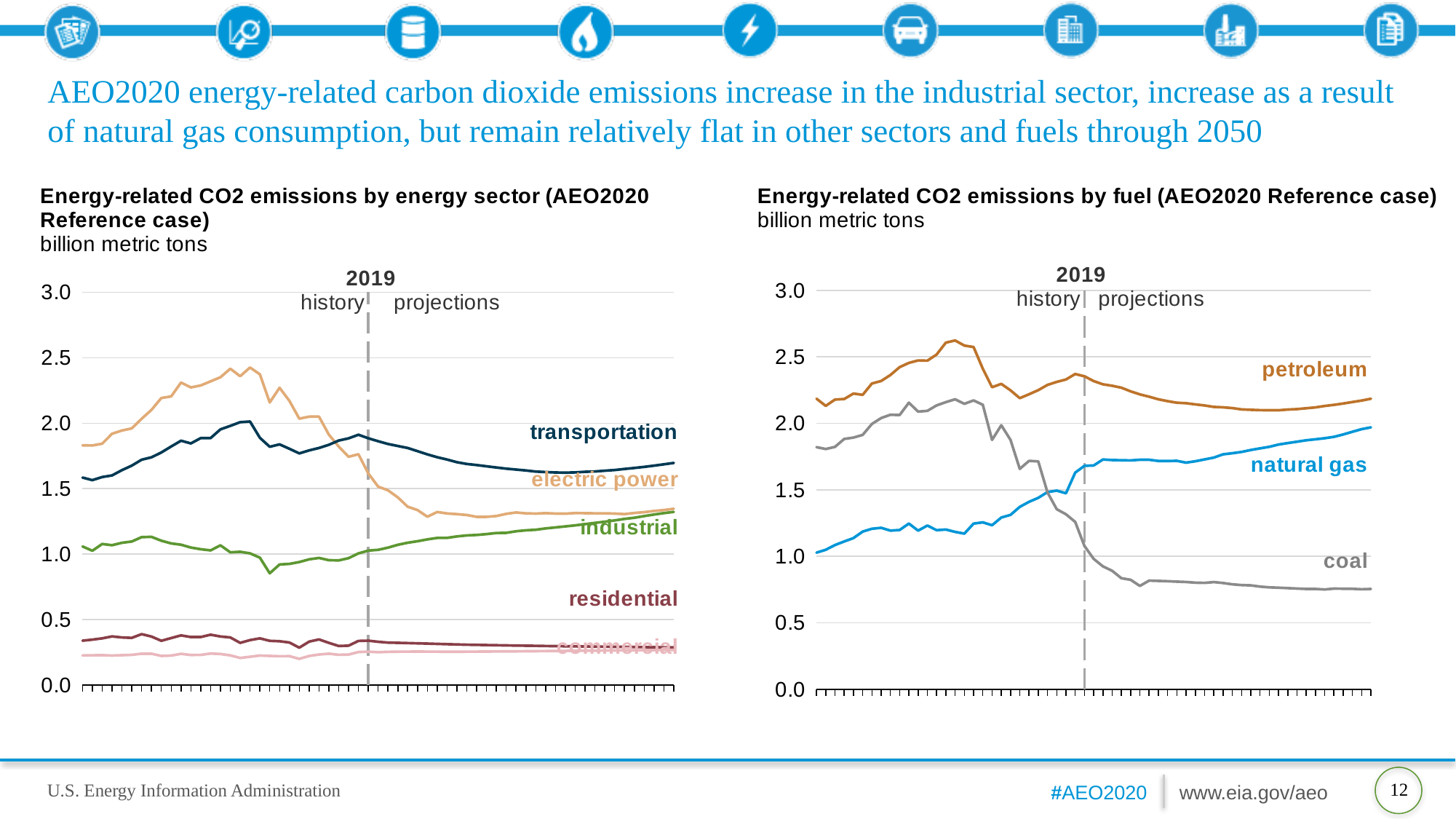
What type of chart is the 'Energy-related CO2 emissions by energy sector' chart on the left? line chart On the left chart (by energy sector), which sector has the highest emissions at the end of the projection period? transportation What unit is used on the y axis of both charts? billion metric tons On the right chart (by fuel), which fuel has the lowest emissions at the end of the projection period? coal On the right chart (by fuel), is the value for coal at the end of the projection period greater or less than 1.0? less How many series are labelled on the right chart, 'Energy-related CO2 emissions by fuel'? 3 On the left chart (by energy sector), is the value for transportation at the end of the projection period greater or less than 1.5? greater On the right chart (by fuel), is the value for petroleum at the end of the projection period greater or less than 2.0? greater On the left chart (by energy sector), which sector has the lowest emissions at the end of the projection period? commercial On the right chart (by fuel), which is larger at the end of the projection period, petroleum or natural gas? petroleum How many series are labelled on the left chart, 'Energy-related CO2 emissions by energy sector'? 5 On the right chart (by fuel), does the coal series rise or fall over the projection period? fall